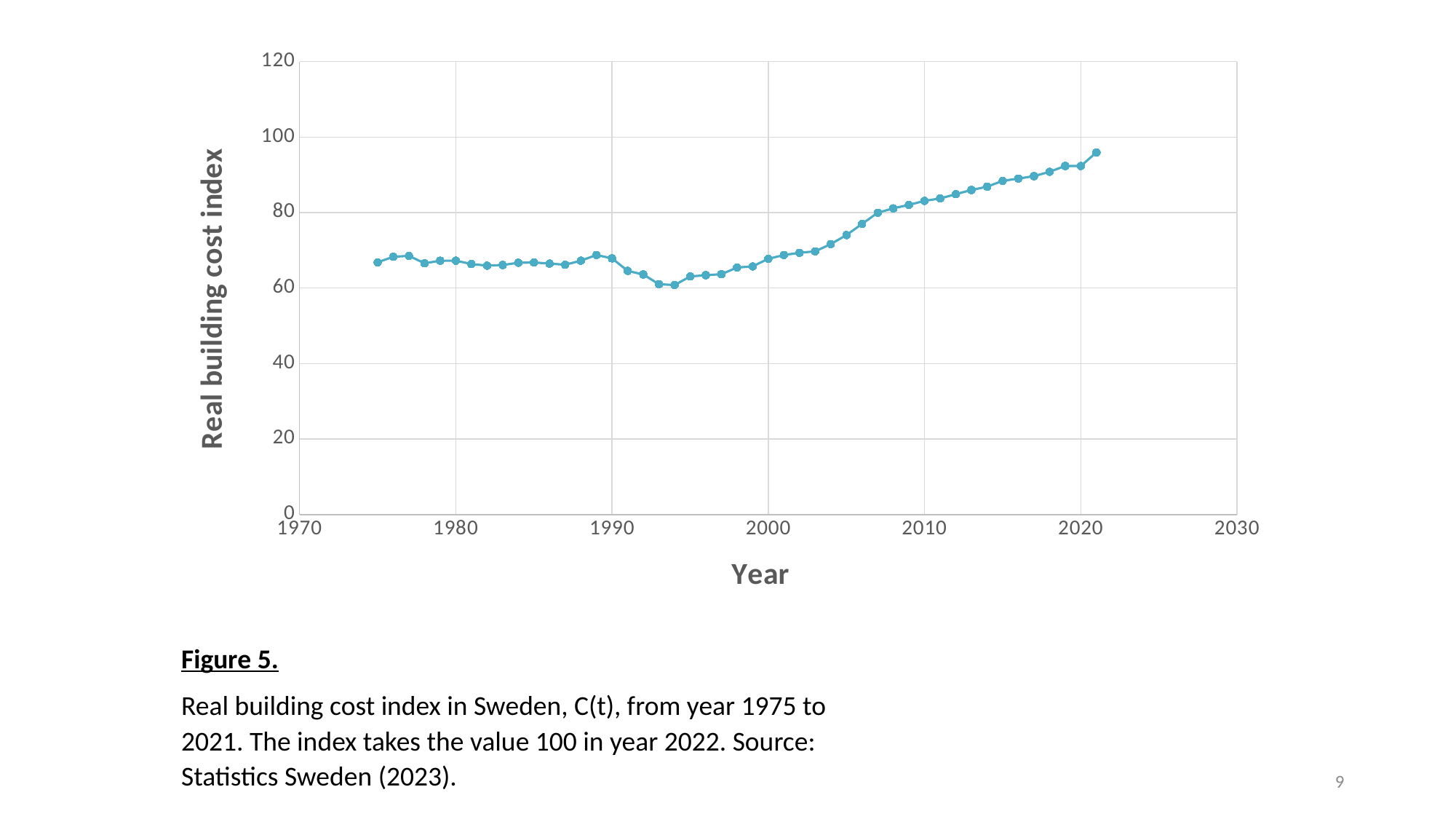
Does the real building cost index rise or fall between 1989 and 1994? fall Is the real building cost index in 1975 greater or less than 60? greater Which year has the larger real building cost index, 1975 or 2021? 2021 Is the real building cost index in 2021 greater or less than 100? less What is the label of the vertical axis? Real building cost index In which year does the real building cost index reach its highest value? 2021 What kind of chart is shown on the slide? Line chart What is the label of the horizontal axis? Year Does the real building cost index rise or fall between 2000 and 2021? rise Is the real building cost index in 2000 greater or less than 80? less Which year has the larger real building cost index, 1989 or 1994? 1989